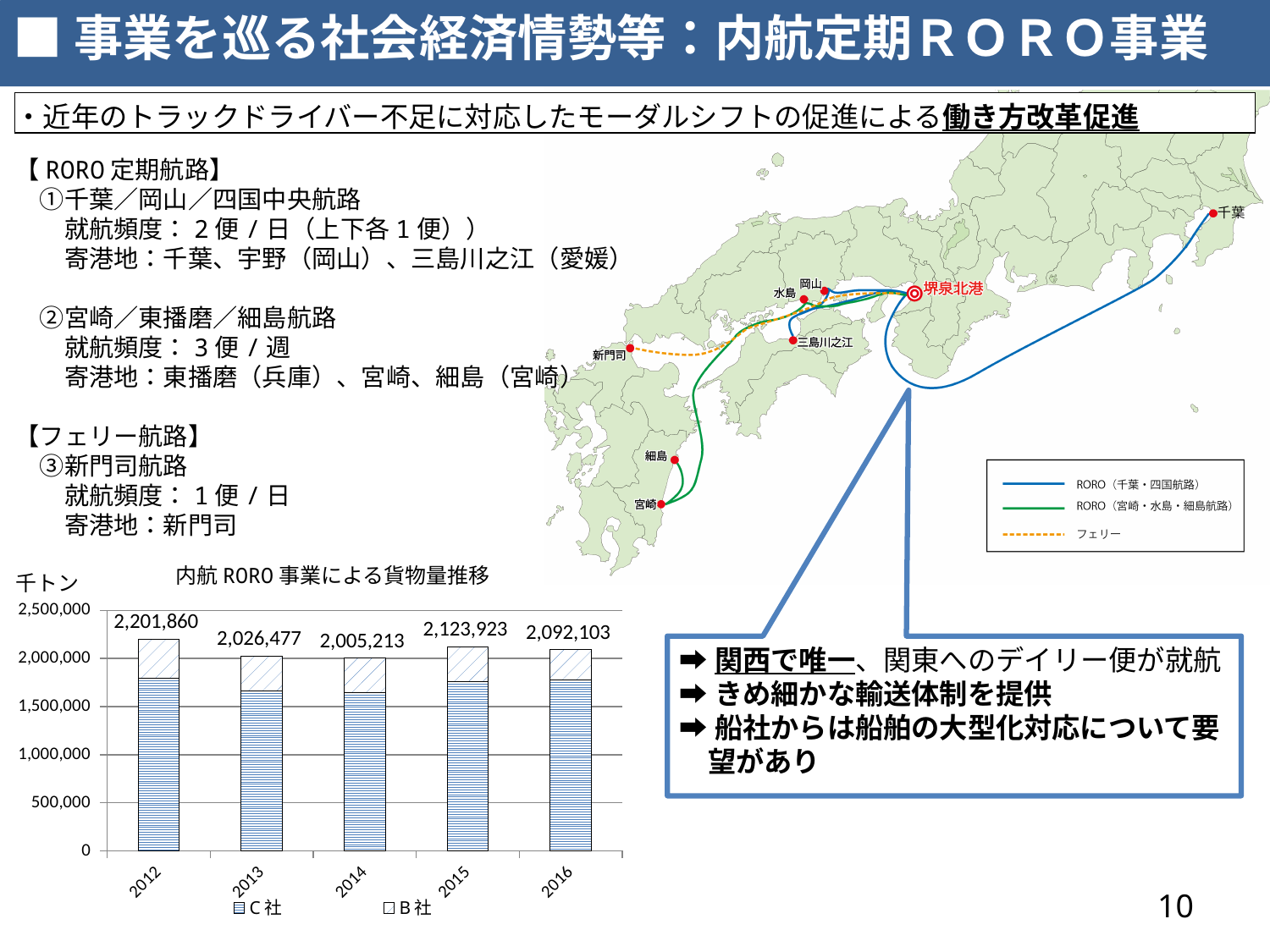
In the 内航RORO事業による貨物量推移 chart, is the value for C社 in 2012 greater or less than 1,500,000? greater Which year has the highest total cargo volume in the 内航RORO事業による貨物量推移 chart? 2012 How many years are plotted in the 内航RORO事業による貨物量推移 chart? 5 What kind of chart is the 内航RORO事業による貨物量推移 chart? Stacked bar chart What is the total cargo volume shown for 2012 in the 内航RORO事業による貨物量推移 chart? 2,201,860 Which year has the lowest total cargo volume in the 内航RORO事業による貨物量推移 chart? 2014 What is the total cargo volume shown for 2016 in the 内航RORO事業による貨物量推移 chart? 2,092,103 How many series does the legend of the 内航RORO事業による貨物量推移 chart list? 2 In the 内航RORO事業による貨物量推移 chart, what is the difference between the 2015 total and the 2016 total? 31,820 What is the total cargo volume shown for 2014 in the 内航RORO事業による貨物量推移 chart? 2,005,213 In the 内航RORO事業による貨物量推移 chart, which year has the larger total, 2013 or 2015? 2015 In the 内航RORO事業による貨物量推移 chart, what is the difference between the 2012 total and the 2013 total? 175,383